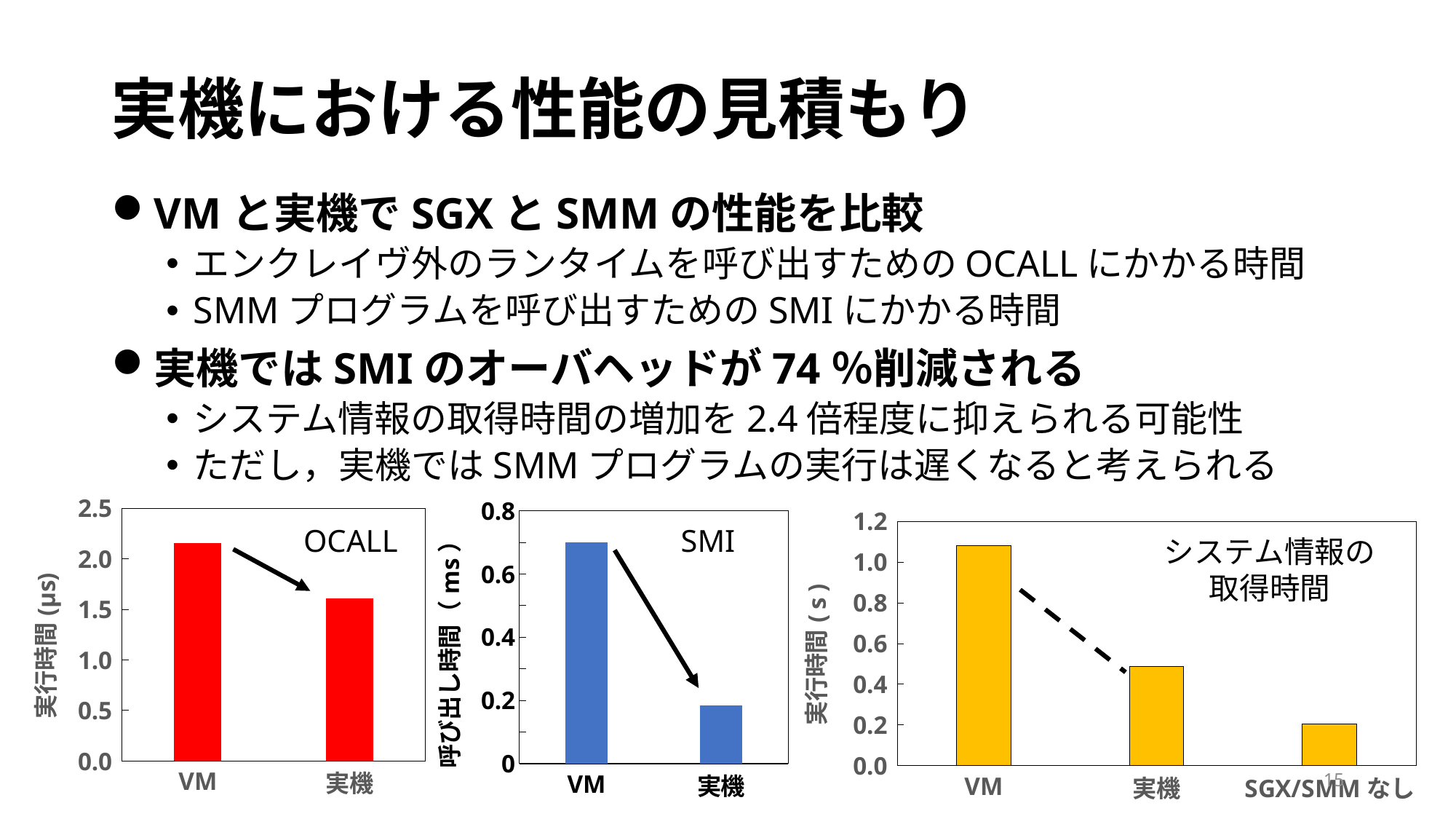
In the SMI chart, is the value for 実機 greater or less than 0.4? less In the OCALL chart, which category has the higher value, VM or 実機? VM In the システム情報の取得時間 chart, do the values rise or fall from left to right along the x axis? fall In the OCALL chart, is the value for 実機 greater or less than 2.0? less In the システム情報の取得時間 chart, is the value for SGX/SMM なし greater or less than 0.4? less What kind of chart is the OCALL chart on the left? bar chart In the システム情報の取得時間 chart on the right, how many categories are shown on the x axis? 3 In the OCALL chart, how many categories are shown on the x axis? 2 In the SMI chart, which category has the lowest value? 実機 In the システム情報の取得時間 chart, which category has the highest value? VM